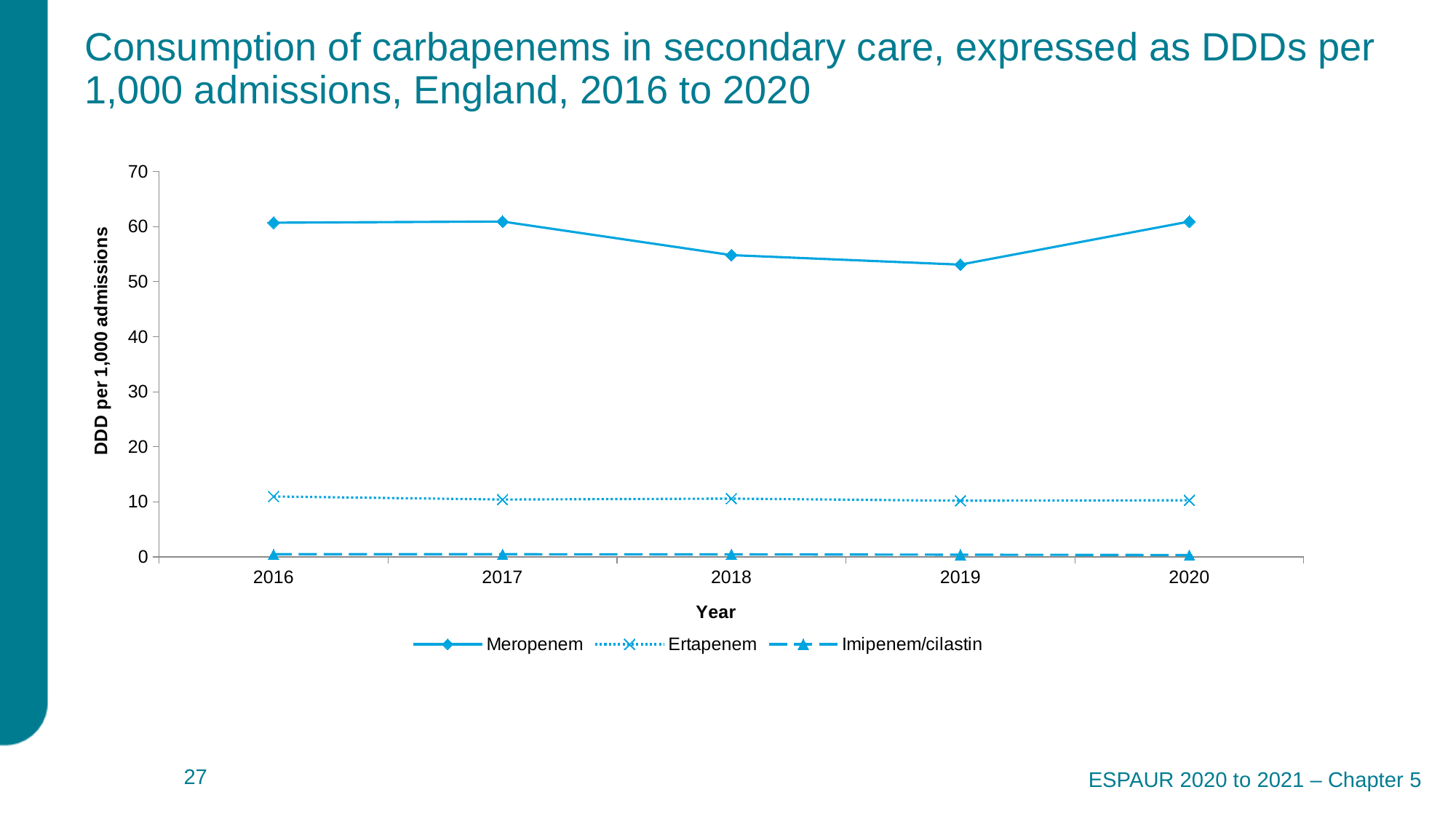
Which series has the lowest values across all years? Imipenem/cilastin How many years are plotted along the x axis? 5 Which is larger in 2020, the value for Meropenem or the value for Ertapenem? Meropenem Is the value for Imipenem/cilastin in 2018 greater or less than 10? less Is the value for Meropenem in 2019 greater or less than 60? less In which year is the Meropenem value lowest? 2019 Is the value for Meropenem in 2016 greater or less than 50? greater Does the Meropenem value rise or fall from 2017 to 2019? fall Which series has the highest values across all years? Meropenem How many series does the legend list? 3 What kind of chart is shown on the slide? line chart